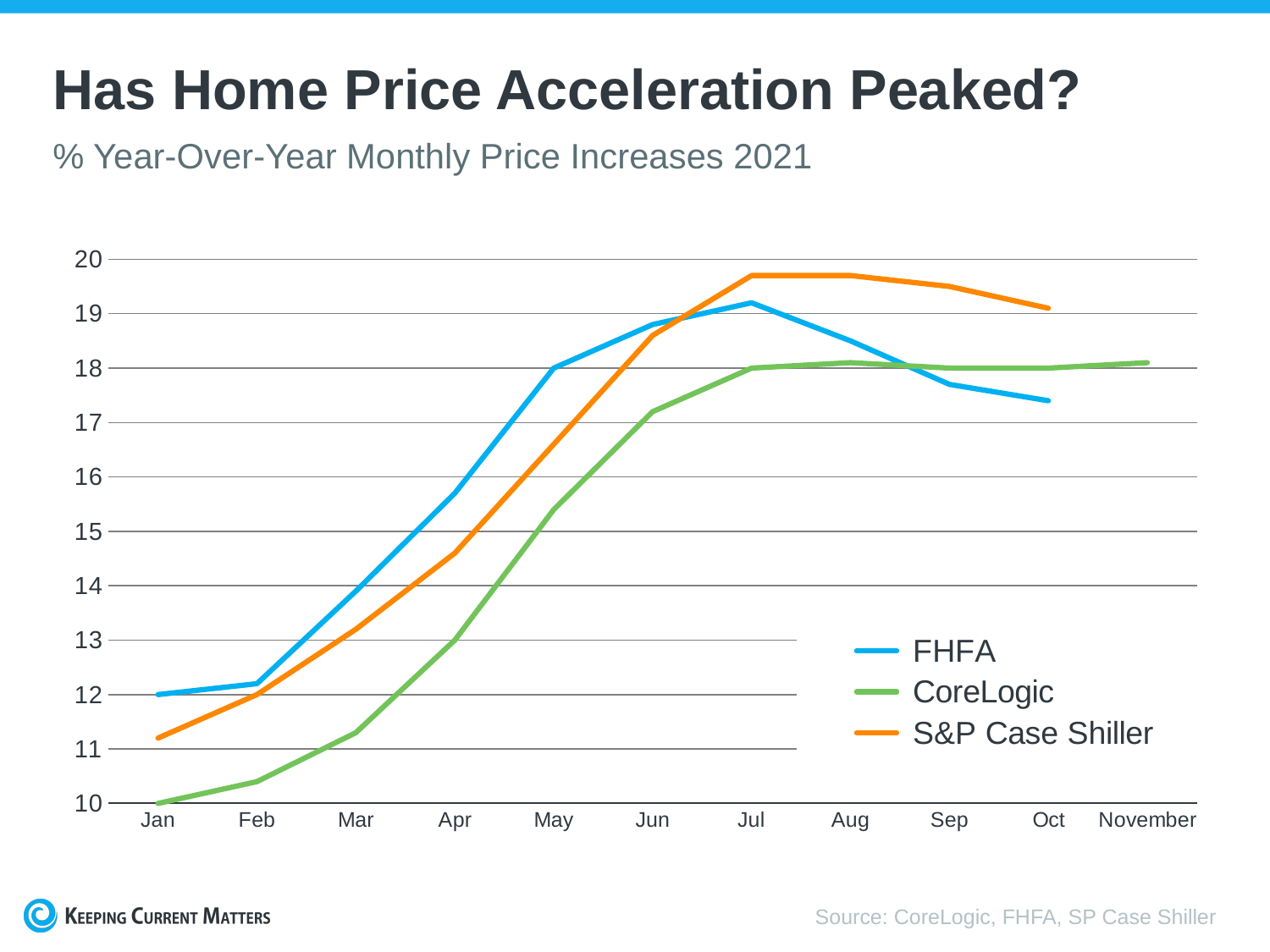
In which month does the FHFA line reach its highest value? Jul What is the FHFA value for Jan? 12 How many months are shown on the x axis? 11 Is the FHFA value for Oct greater or less than 18? less What kind of chart is shown on the slide? line chart Is the S&P Case Shiller value for Jul greater or less than 19? greater What is the title of the chart on the slide? Has Home Price Acceleration Peaked? Does the FHFA line rise or fall from Jul to Oct? fall Is the CoreLogic value for Apr greater or less than 14? less What is the CoreLogic value for Jan? 10 How many series does the legend list? 3 In Jul, which is higher: S&P Case Shiller or FHFA? S&P Case Shiller